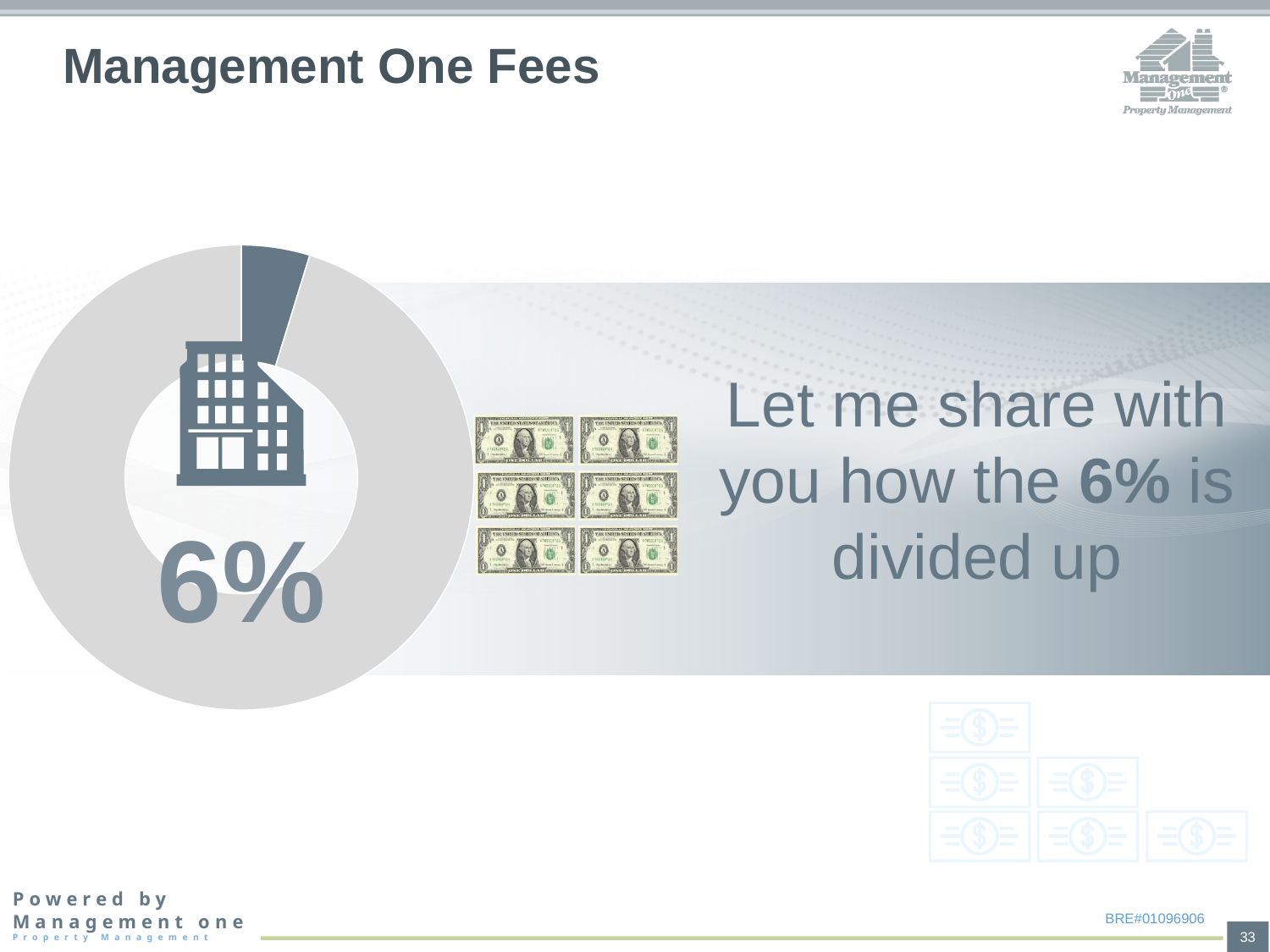
Is the dark highlighted slice of the donut chart greater or less than 50% of the whole? less What icon is shown inside the donut chart on the left of the slide? A building What percentage is printed on the donut chart on the left of the slide? 6% What is the title of the slide containing the donut chart? Management One Fees How many slices does the donut chart on the left of the slide have? 2 In the donut chart, which slice is larger: the dark highlighted slice or the light grey slice? The light grey slice What share of the donut chart does the dark highlighted slice represent? 6% What kind of chart is shown on the left of the slide? Pie (donut) chart